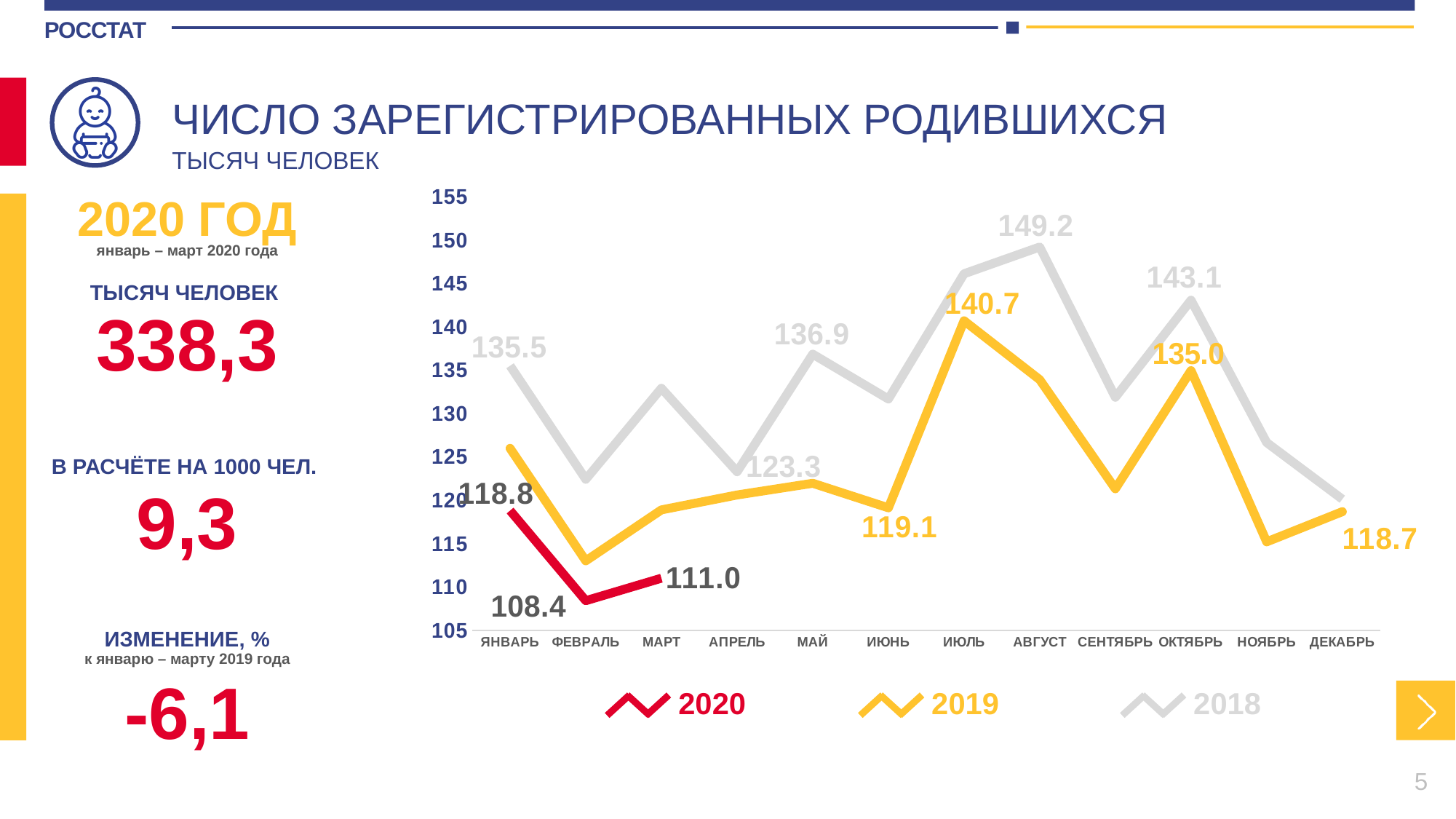
Is the value for November in the 2019 series greater or less than 120? less How many series does the legend list? 3 What is the value for February in the 2020 series? 108.4 Does the 2020 series rise or fall from January to February? fall In which month does the 2018 series reach its highest value? August What kind of chart is shown on the slide? line chart What is the value for July in the 2019 series? 140.7 What is the difference between the January and February values of the 2020 series? 10.4 What is the value for December in the 2019 series? 118.7 How many months are shown on the x axis? 12 Which is larger: the 2019 value for July or the 2018 value for August? 2018 value for August What is the value for August in the 2018 series? 149.2